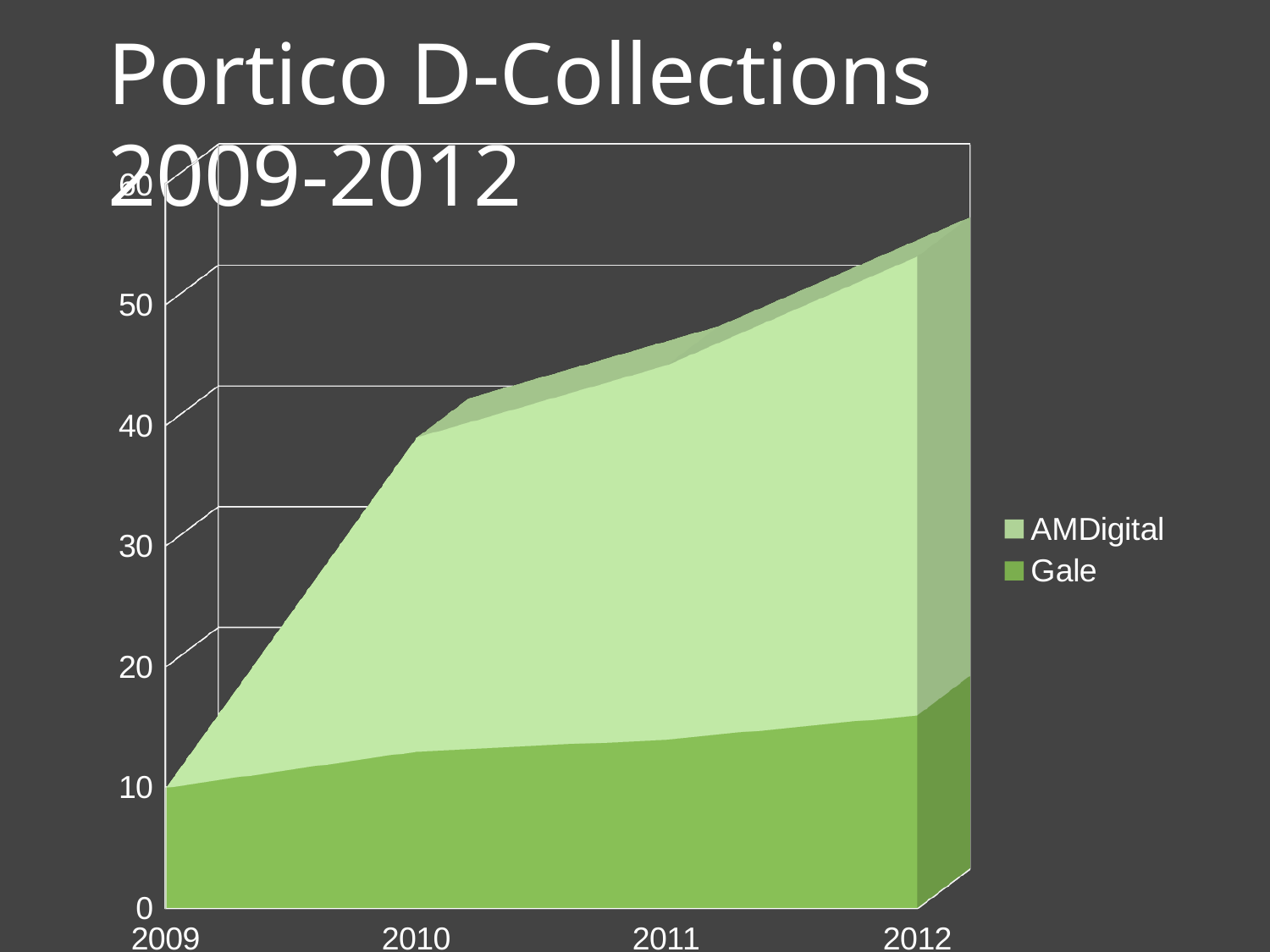
Is the combined stacked total in 2010 greater or less than 30? greater Which is larger, the combined stacked total in 2012 or in 2010? 2012 In which year is the combined stacked total highest? 2012 Does the combined total of the stacked areas rise or fall from 2009 to 2012? Rise What is the title of the chart? Portico D-Collections 2009-2012 Which series are listed in the legend? AMDigital and Gale How many series does the legend list? 2 In which year is the combined stacked total lowest? 2009 Is the combined stacked total in 2012 greater or less than 40? greater How many years are plotted along the x axis? 4 What kind of chart is shown on the slide? Area chart Is the value for Gale in 2009 greater or less than 20? less